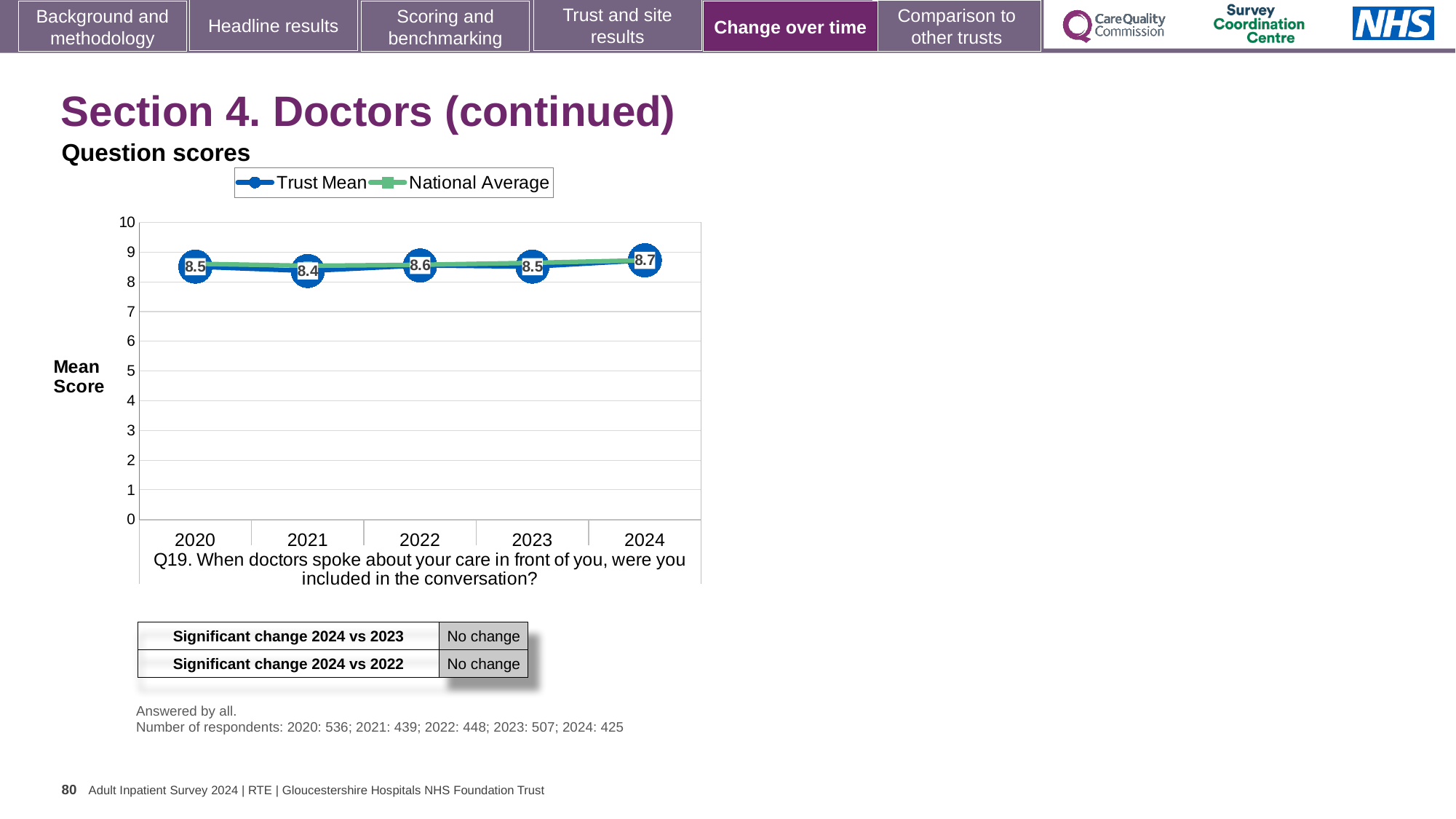
Which year has the larger Trust Mean score, 2022 or 2021? 2022 How many series does the chart legend list? 2 What kind of chart is shown on the slide? Line chart What is the Trust Mean score for 2024? 8.7 Is the Trust Mean score for 2023 greater or less than 5? greater What is the Trust Mean score for 2022? 8.6 What are the two series named in the chart legend? Trust Mean and National Average What is the difference between the Trust Mean scores for 2024 and 2021? 0.3 In which year is the Trust Mean score lowest? 2021 In which year is the Trust Mean score highest? 2024 What is the Trust Mean score for 2021? 8.4 How many years are shown on the x axis of the chart? 5